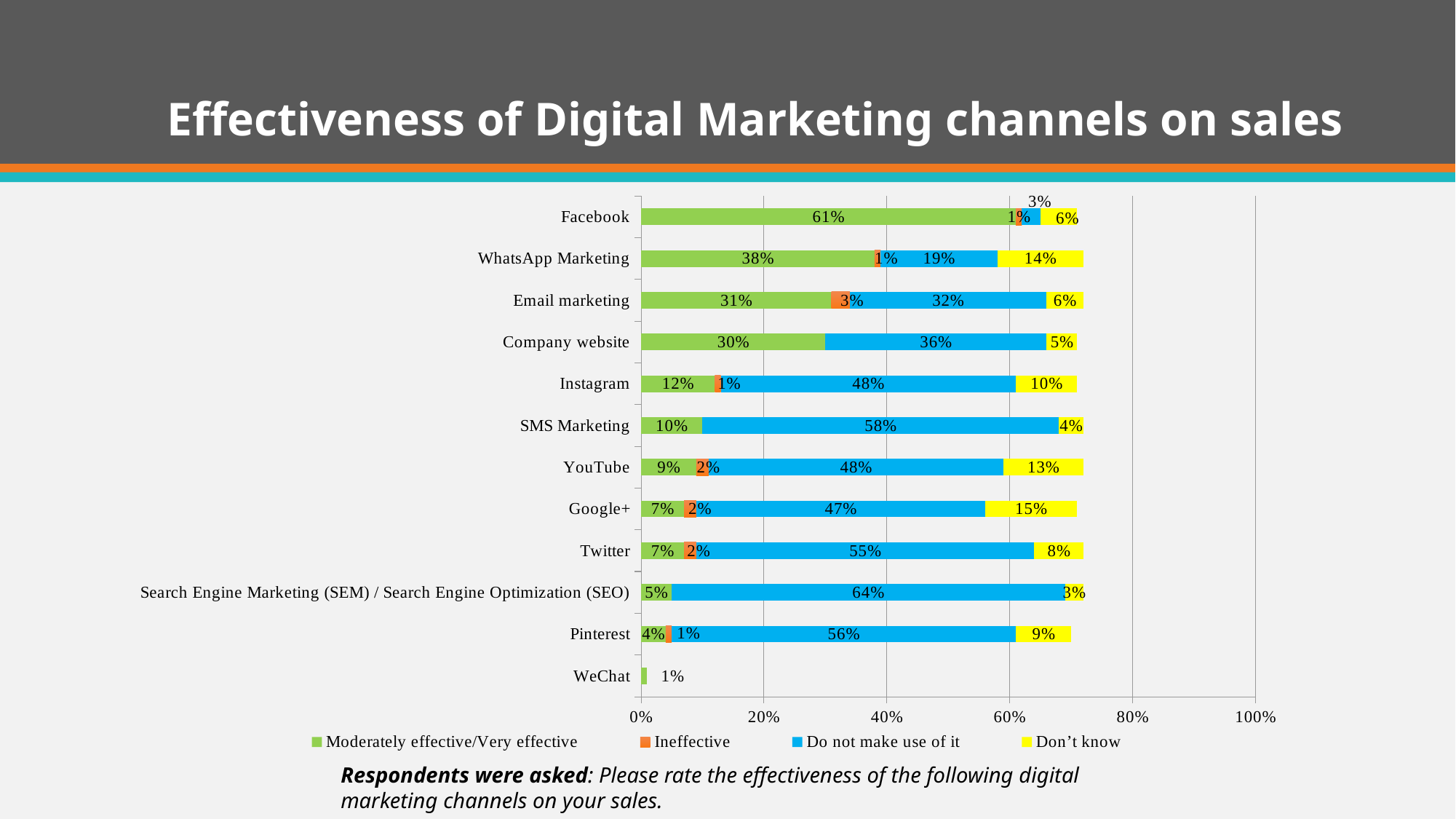
What is the 'Don't know' value for WhatsApp Marketing? 14% What is the difference between the 'Moderately effective/Very effective' values for Facebook and WhatsApp Marketing? 23 percentage points What is the 'Do not make use of it' value for SMS Marketing? 58% What percentage of respondents rated Facebook as moderately effective/very effective? 61% Which has a larger 'Do not make use of it' value, Email marketing or Company website? Company website Which channel has the highest 'Don't know' value? Google+ Which channel has the highest 'Moderately effective/Very effective' value? Facebook What kind of chart is shown on the slide? Stacked bar chart How many digital marketing channels are listed on the chart? 12 Which channel has the highest 'Do not make use of it' value? Search Engine Marketing (SEM) / Search Engine Optimization (SEO) What is the total of the stacked bar for Facebook? 71% How many series does the legend list? 4